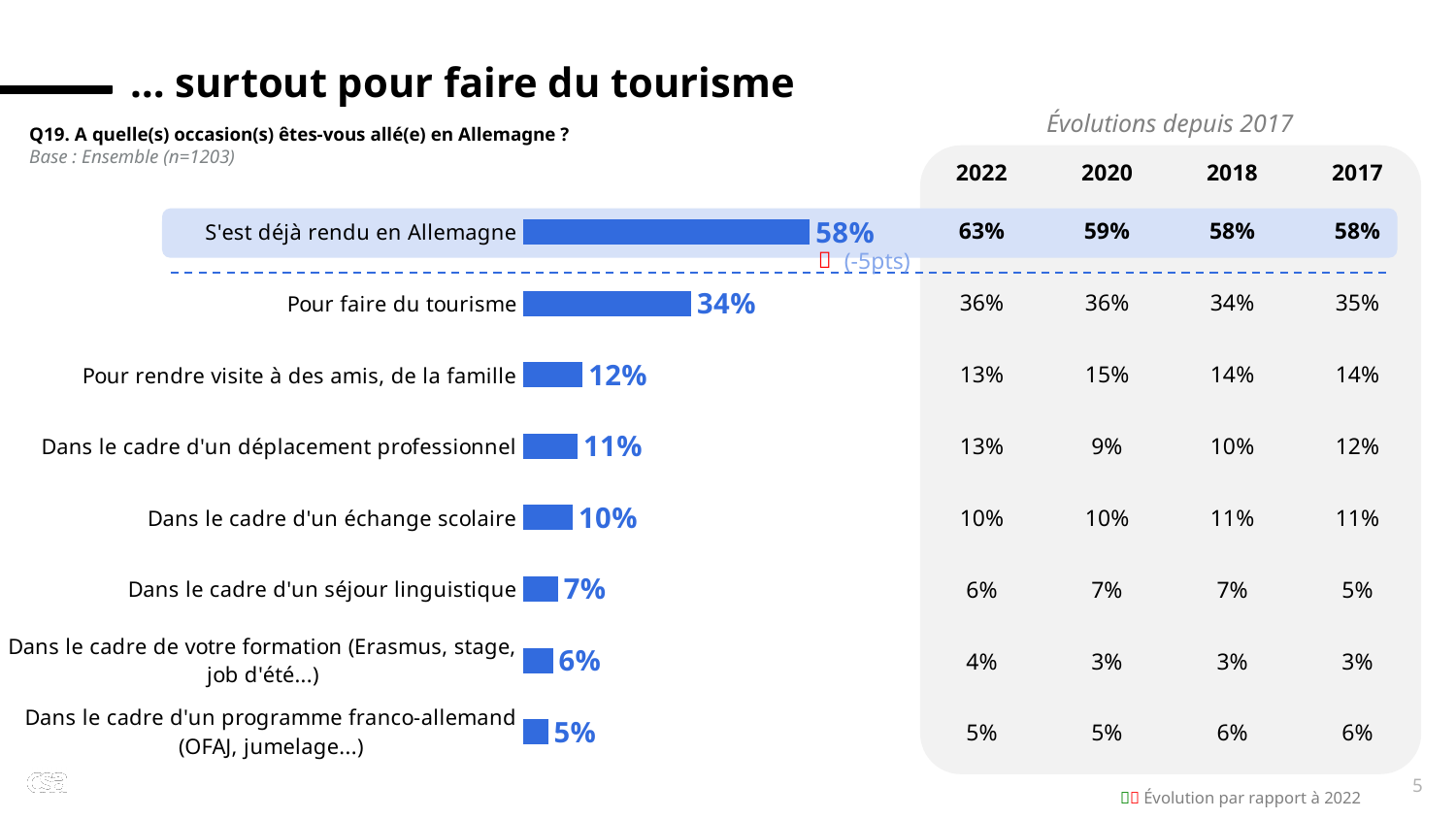
Which category has the lowest value in the chart? Dans le cadre d'un programme franco-allemand (OFAJ, jumelage…) How many categories (bars) are shown in the chart? 8 What is the difference between "Dans le cadre d'un séjour linguistique" and "Dans le cadre de votre formation (Erasmus, stage, job d'été…)"? 1 point What is the value for "S'est déjà rendu en Allemagne"? 58% Which is larger: "Pour rendre visite à des amis, de la famille" or "Dans le cadre d'un échange scolaire"? Pour rendre visite à des amis, de la famille Which category has the highest value in the chart? S'est déjà rendu en Allemagne What is the value for "Dans le cadre d'un déplacement professionnel"? 11% What kind of chart is shown on the slide? bar chart What change since 2022 is indicated next to the "S'est déjà rendu en Allemagne" bar? -5pts What is the value for "Pour faire du tourisme"? 34% What is the difference between "S'est déjà rendu en Allemagne" and "Pour faire du tourisme"? 24 points What is the value for "Dans le cadre d'un programme franco-allemand (OFAJ, jumelage…)"? 5%